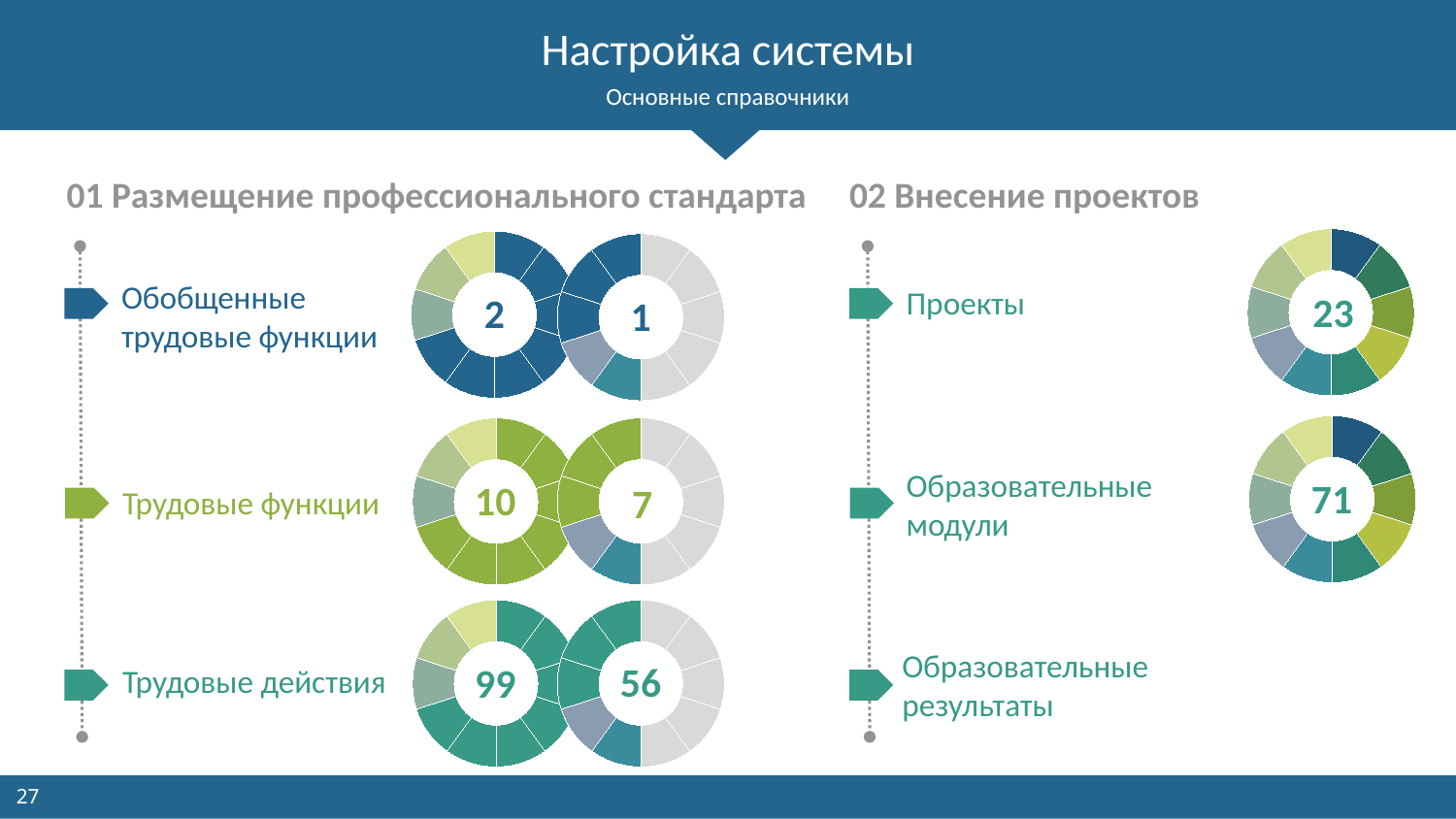
What number is shown in the centre of the right donut chart in the 'Обобщенные трудовые функции' row? 1 What number is shown in the centre of the left donut chart in the 'Трудовые функции' row? 10 What is the difference between the two numbers shown in the donut charts of the 'Трудовые действия' row (99 and 56)? 43 Which is larger: the number in the 'Проекты' donut chart or the number in the 'Образовательные модули' donut chart? Образовательные модули What number is shown in the centre of the right donut chart in the 'Трудовые функции' row? 7 What kind of chart is used to display the numbers on this slide? Donut chart What number is shown in the centre of the left donut chart in the 'Обобщенные трудовые функции' row? 2 How many donut charts are shown on the slide in total? 8 What number is shown in the centre of the donut chart next to 'Образовательные модули'? 71 What number is shown in the centre of the donut chart next to 'Проекты'? 23 What number is shown in the centre of the left donut chart in the 'Трудовые действия' row? 99 What is the difference between the number in the 'Образовательные модули' donut chart and the number in the 'Проекты' donut chart? 48